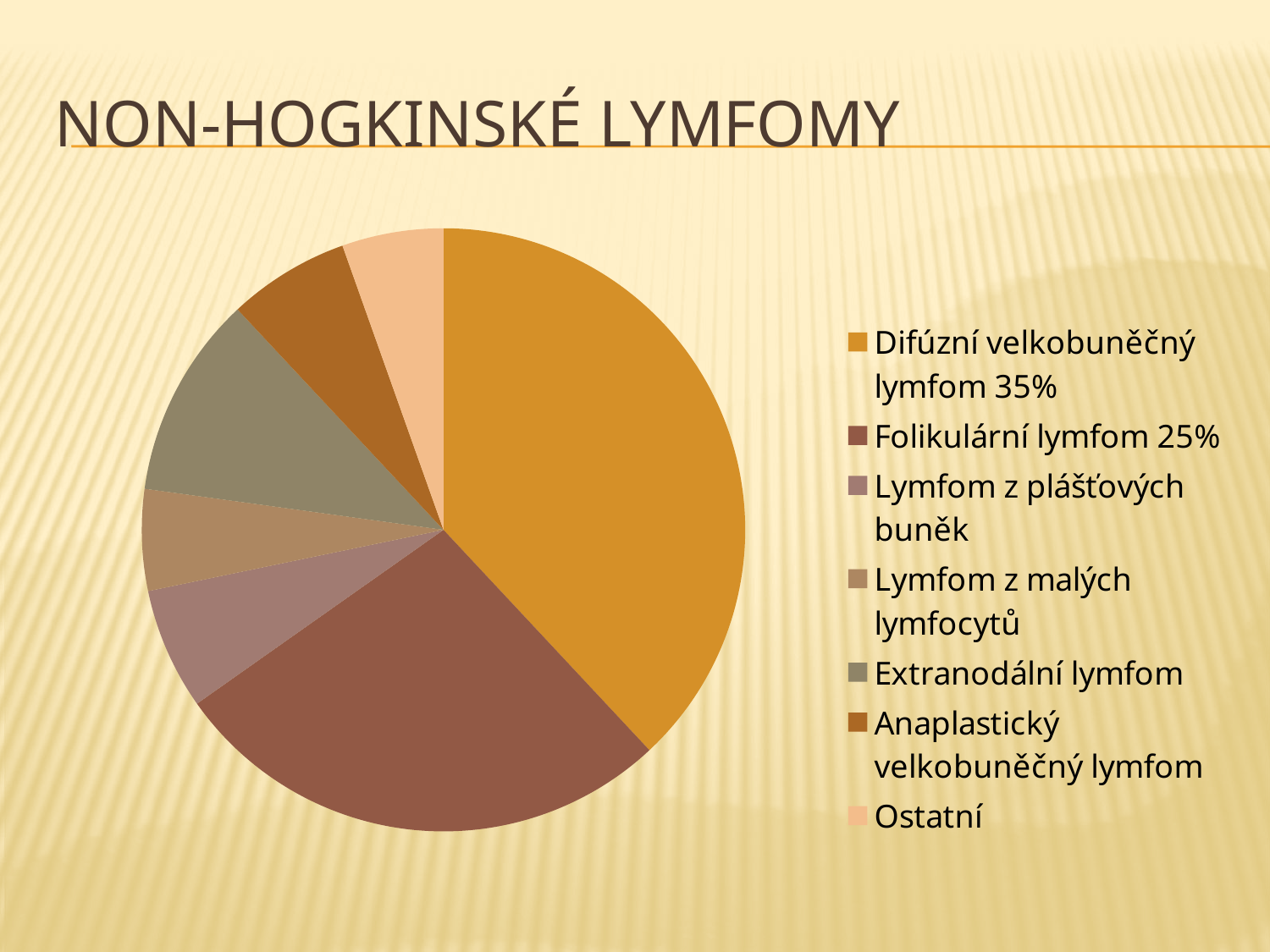
How many slices does the pie chart have? 7 What is the difference between the shares of Difúzní velkobuněčný lymfom and Folikulární lymfom? 10% What share of the pie does Difúzní velkobuněčný lymfom represent? 35% What is the title of the slide containing the pie chart? NON-HOGKINSKÉ LYMFOMY Which is larger, the slice for Extranodální lymfom or the slice for Ostatní? Extranodální lymfom What is the combined share of Difúzní velkobuněčný lymfom and Folikulární lymfom? 60% What kind of chart is shown on the slide? pie chart Which is larger, the slice for Difúzní velkobuněčný lymfom or the slice for Folikulární lymfom? Difúzní velkobuněčný lymfom What share of the pie does Folikulární lymfom represent? 25% Which category has the largest slice of the pie? Difúzní velkobuněčný lymfom Which is larger, the slice for Folikulární lymfom or the slice for Extranodální lymfom? Folikulární lymfom Which legend entry is listed last in the pie chart's legend? Ostatní